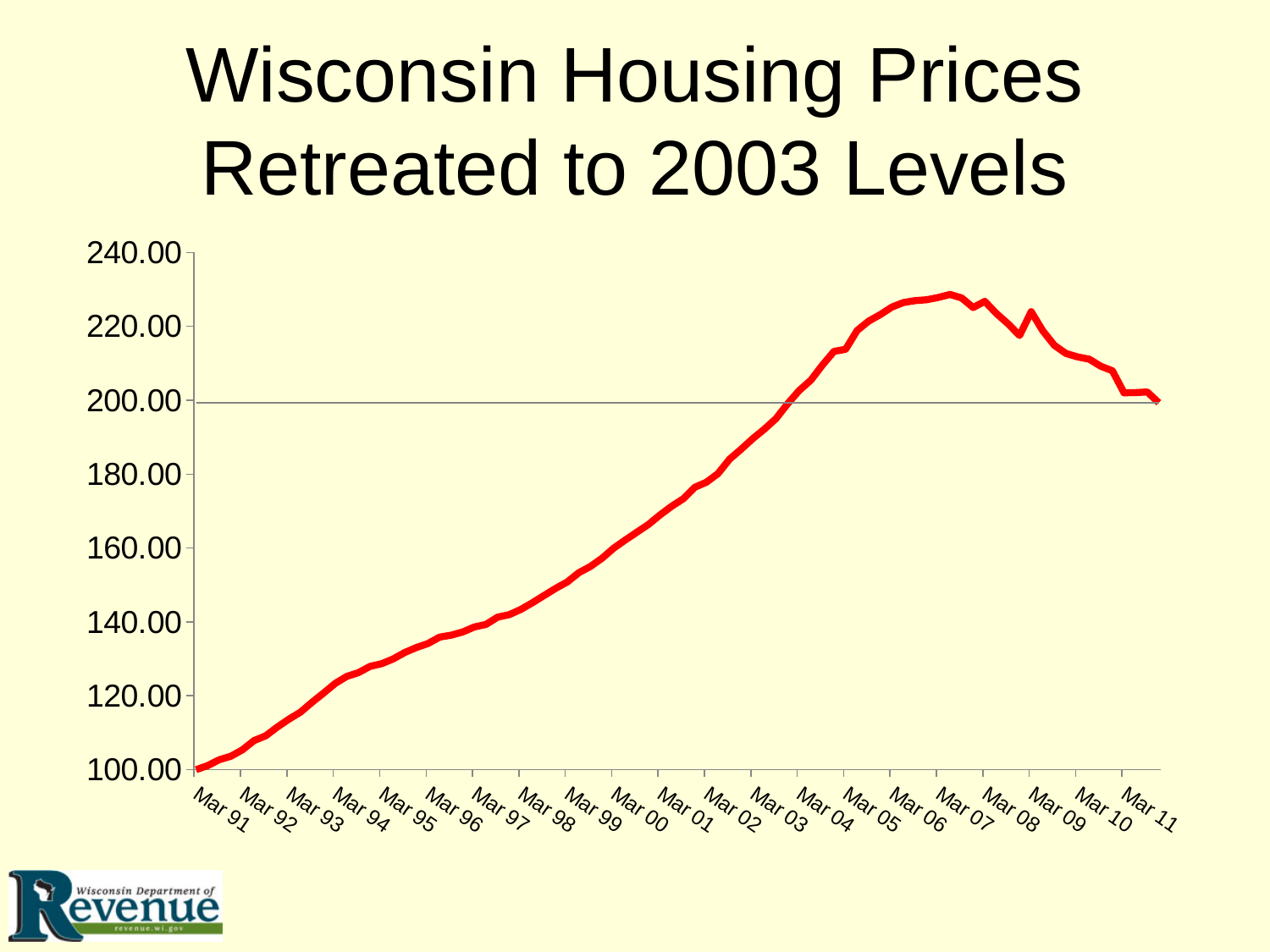
Is the value for Mar 09 greater or less than 200? greater What is the title of the chart on the slide? Wisconsin Housing Prices Retreated to 2003 Levels Do the values rise or fall along the x axis from Mar 91 to Mar 06? rise Is the value for Mar 98 greater or less than 140? greater What is the value of the line at Mar 91? 100.00 At which x-axis label is the line at its lowest value? Mar 91 How many year labels are shown along the x axis? 21 Is the value for Mar 00 greater or less than 180? less Do the values rise or fall along the x axis from Mar 07 to Mar 11? fall What kind of chart is shown on the slide? line chart Which is larger, the value for Mar 05 or the value for Mar 09? Mar 09